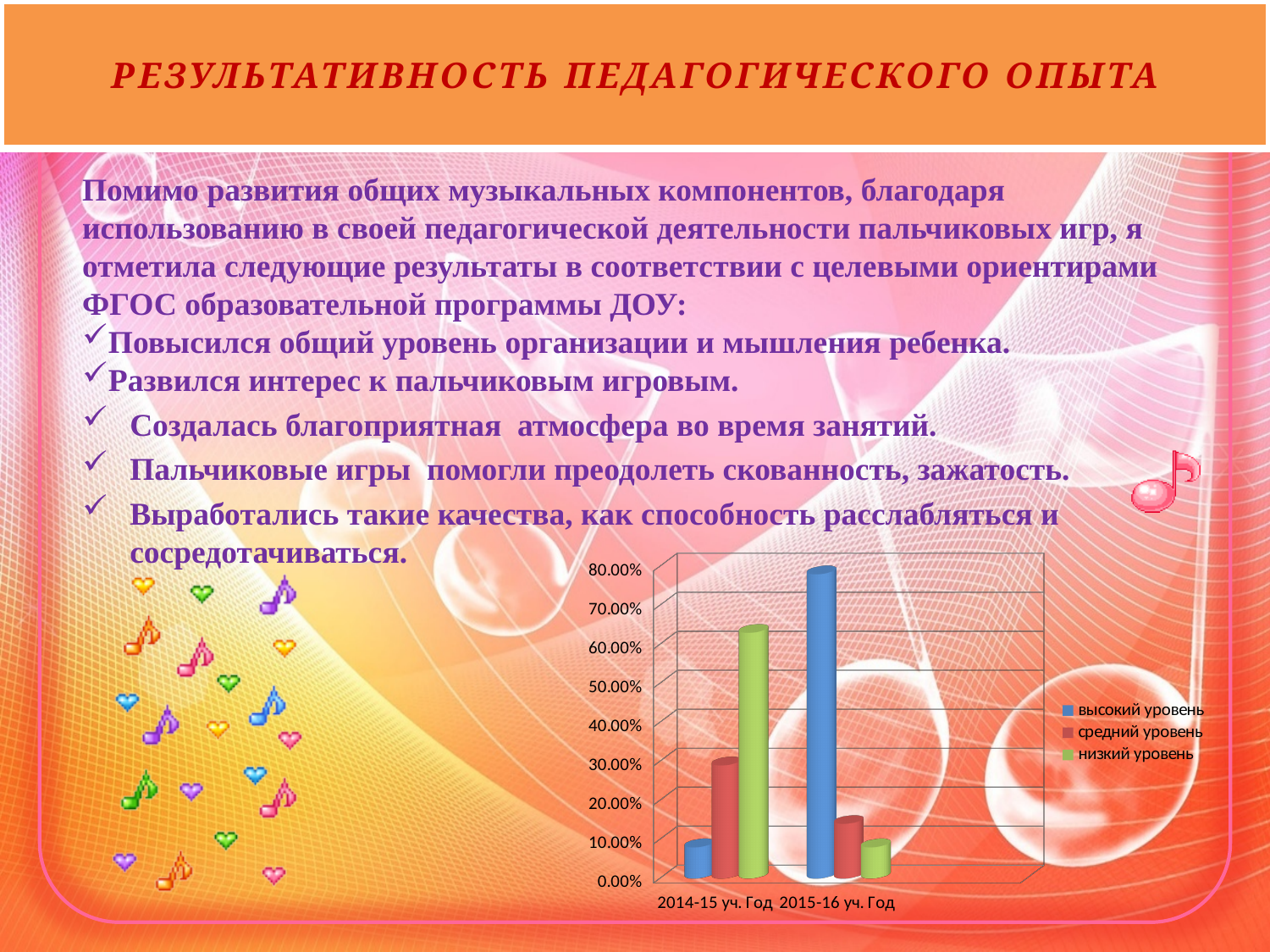
Which colour represents средний уровень in the chart legend? red What kind of chart is shown on the slide? bar chart Does the value for высокий уровень rise or fall from 2014-15 уч. Год to 2015-16 уч. Год? rise Which series has the tallest bar for 2015-16 уч. Год? высокий уровень How many series does the chart legend list? 3 Is the value for высокий уровень in 2015-16 уч. Год greater or less than 70.00%? greater Which series has the tallest bar for 2014-15 уч. Год? низкий уровень Is the value for высокий уровень in 2014-15 уч. Год greater or less than 20.00%? less Is the value for низкий уровень in 2015-16 уч. Год greater or less than 20.00%? less How many categories are shown on the x axis of the chart? 2 Which series has the shortest bar for 2014-15 уч. Год? высокий уровень